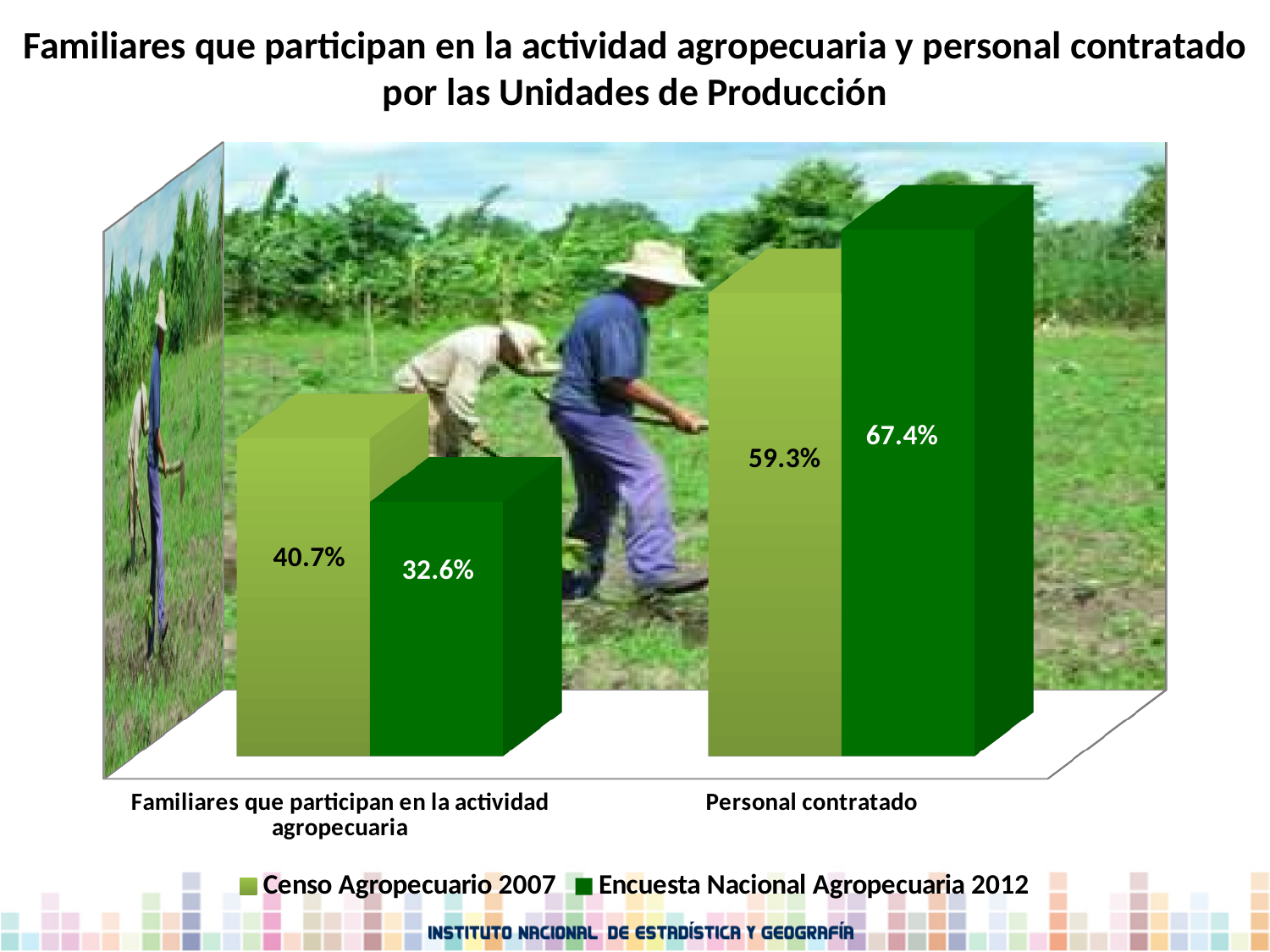
What is the value for Personal contratado in the Censo Agropecuario 2007 series? 59.3% How many series does the legend list? 2 What is the value for Familiares que participan en la actividad agropecuaria in the Encuesta Nacional Agropecuaria 2012 series? 32.6% What is the difference between the Censo Agropecuario 2007 and Encuesta Nacional Agropecuaria 2012 values for Personal contratado? 8.1% What is the value for Familiares que participan en la actividad agropecuaria in the Censo Agropecuario 2007 series? 40.7% For Familiares que participan en la actividad agropecuaria, which series has the larger value: Censo Agropecuario 2007 or Encuesta Nacional Agropecuaria 2012? Censo Agropecuario 2007 What kind of chart is shown on the slide? Bar chart Which category has the lowest value in the Censo Agropecuario 2007 series? Familiares que participan en la actividad agropecuaria What is the difference between the Censo Agropecuario 2007 and Encuesta Nacional Agropecuaria 2012 values for Familiares que participan en la actividad agropecuaria? 8.1% How many categories are shown on the x axis? 2 What is the value for Personal contratado in the Encuesta Nacional Agropecuaria 2012 series? 67.4% Which category has the highest value in the Encuesta Nacional Agropecuaria 2012 series? Personal contratado